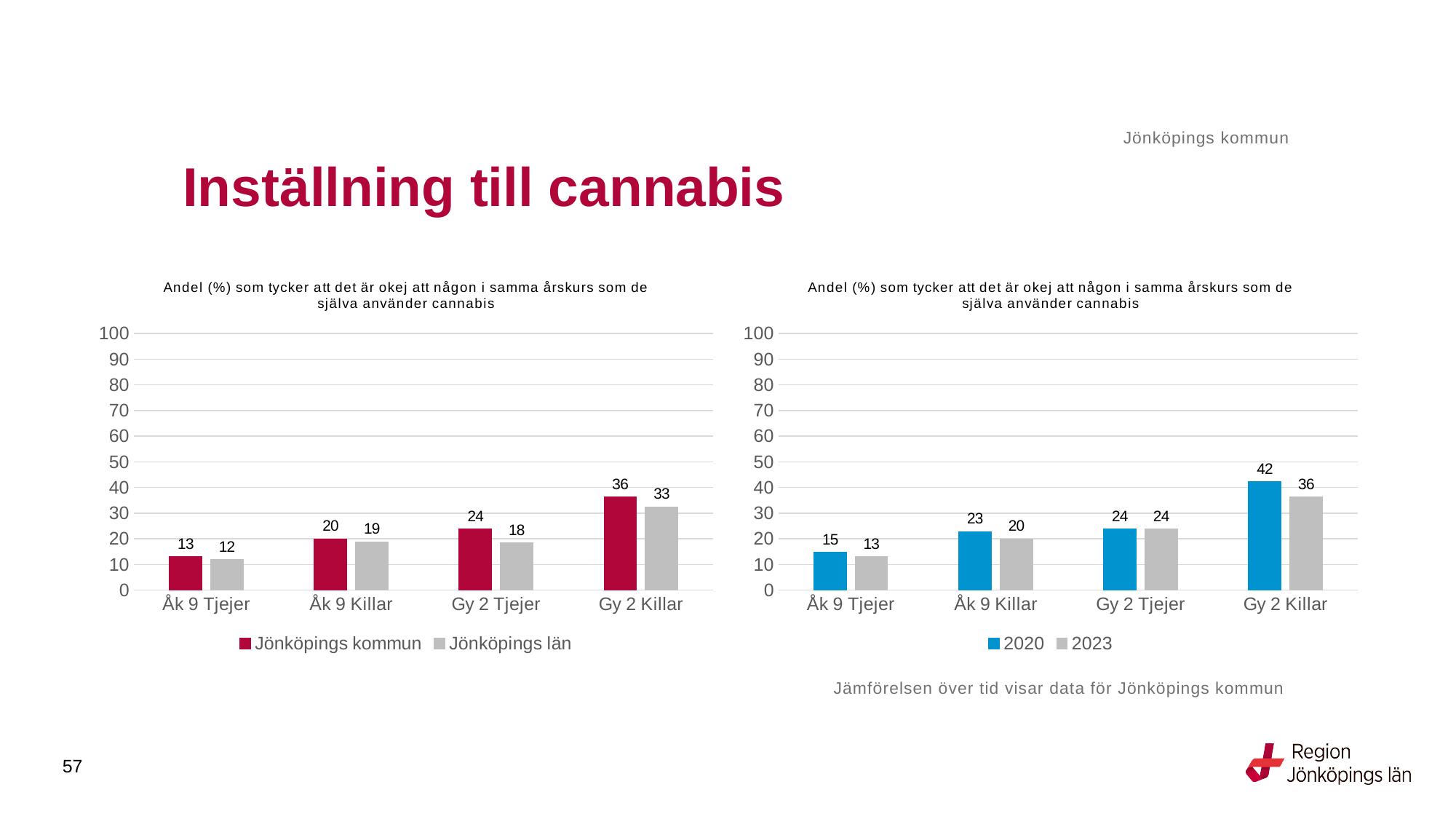
In the right chart, what is the 2023 value for Åk 9 Killar? 20 In the left chart, what is the difference between Jönköpings kommun and Jönköpings län for Gy 2 Tjejer? 6 In the right chart, what is the difference between the 2020 and 2023 values for Gy 2 Killar? 6 In the right chart, which category has the lowest 2023 value? Åk 9 Tjejer How many series does the legend of the right chart list? 2 In the left chart, what is the value for Jönköpings kommun for Gy 2 Killar? 36 How many categories are shown on the x axis of the left chart? 4 In the left chart, which category has the highest value for Jönköpings kommun? Gy 2 Killar What type of chart is the left chart? bar chart In the right chart, what is the 2020 value for Gy 2 Killar? 42 In the right chart, is the 2020 value for Åk 9 Killar larger or smaller than the 2023 value for Åk 9 Killar? larger In the left chart, what is the value for Jönköpings län for Åk 9 Tjejer? 12